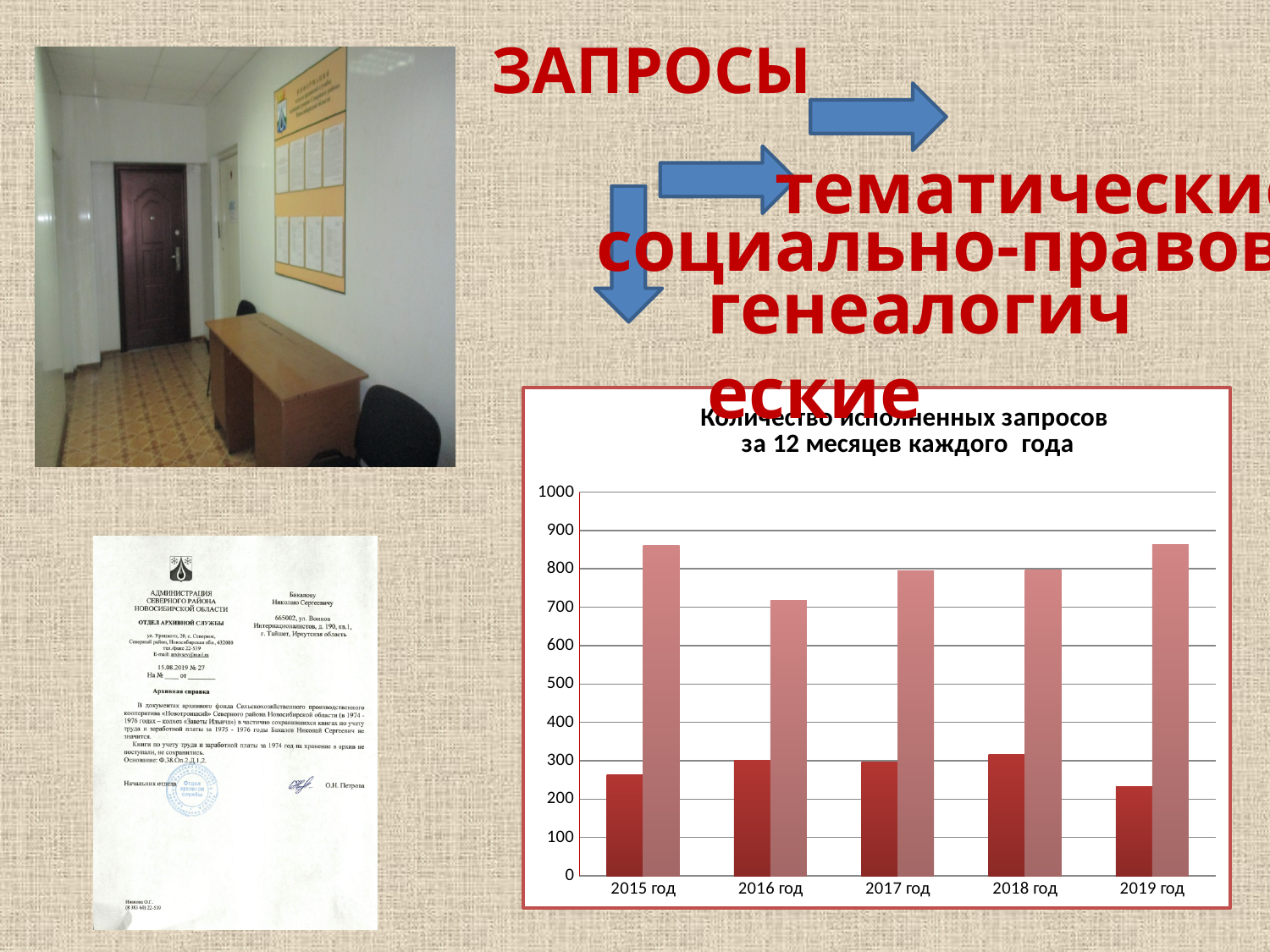
For 2015 год, which bar is taller: the dark red bar or the light pink bar? the light pink bar Is the value of the dark red bar for 2019 год greater or less than 300? less How many bars are plotted for each year in the chart? 2 Which is larger: the light pink bar for 2015 год or the light pink bar for 2016 год? 2015 год What is the title of the chart? Количество исполненных запросов за 12 месяцев каждого года What kind of chart is shown on the slide? bar chart In which year is the light pink bar the lowest? 2016 год Is the value of the dark red bar for 2015 год greater or less than 300? less Is the value of the light pink bar for 2016 год greater or less than 700? greater How many years (categories) are shown on the x axis of the chart? 5 In which year is the dark red bar the lowest? 2019 год